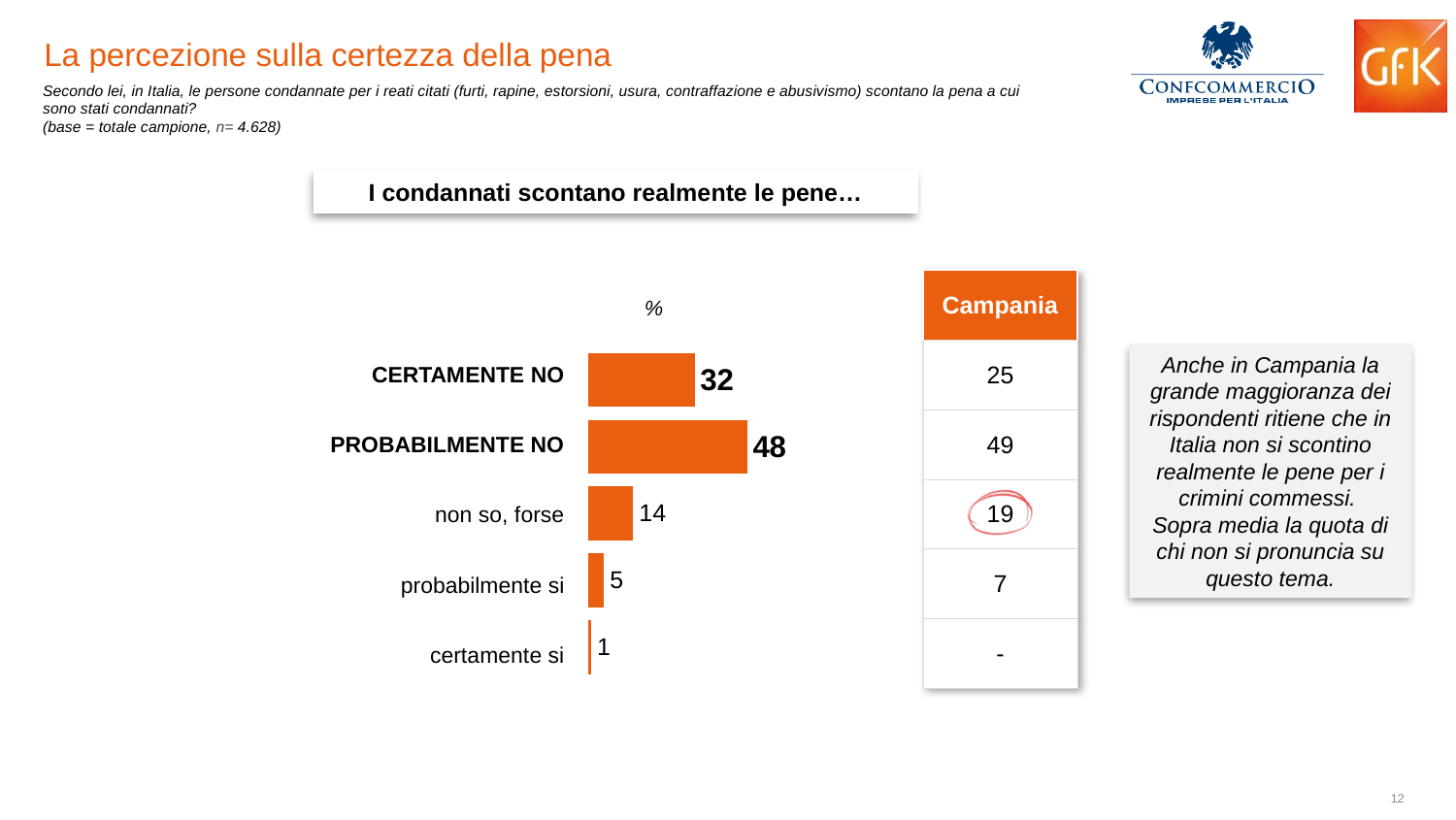
What type of chart is shown on the slide? bar chart What is the difference between the values for PROBABILMENTE NO and CERTAMENTE NO? 16 What is the value for 'non so, forse' in the bar chart? 14 What is the title shown above the bar chart? I condannati scontano realmente le pene… What is the value for 'certamente si' in the bar chart? 1 Which category has the lowest value in the bar chart? certamente si What is the value for CERTAMENTE NO in the bar chart? 32 What is the value for PROBABILMENTE NO in the bar chart? 48 Which category has the highest value in the bar chart? PROBABILMENTE NO Which is larger in the bar chart: 'non so, forse' or 'probabilmente si'? non so, forse What is the value for 'probabilmente si' in the bar chart? 5 How many categories are shown in the bar chart? 5